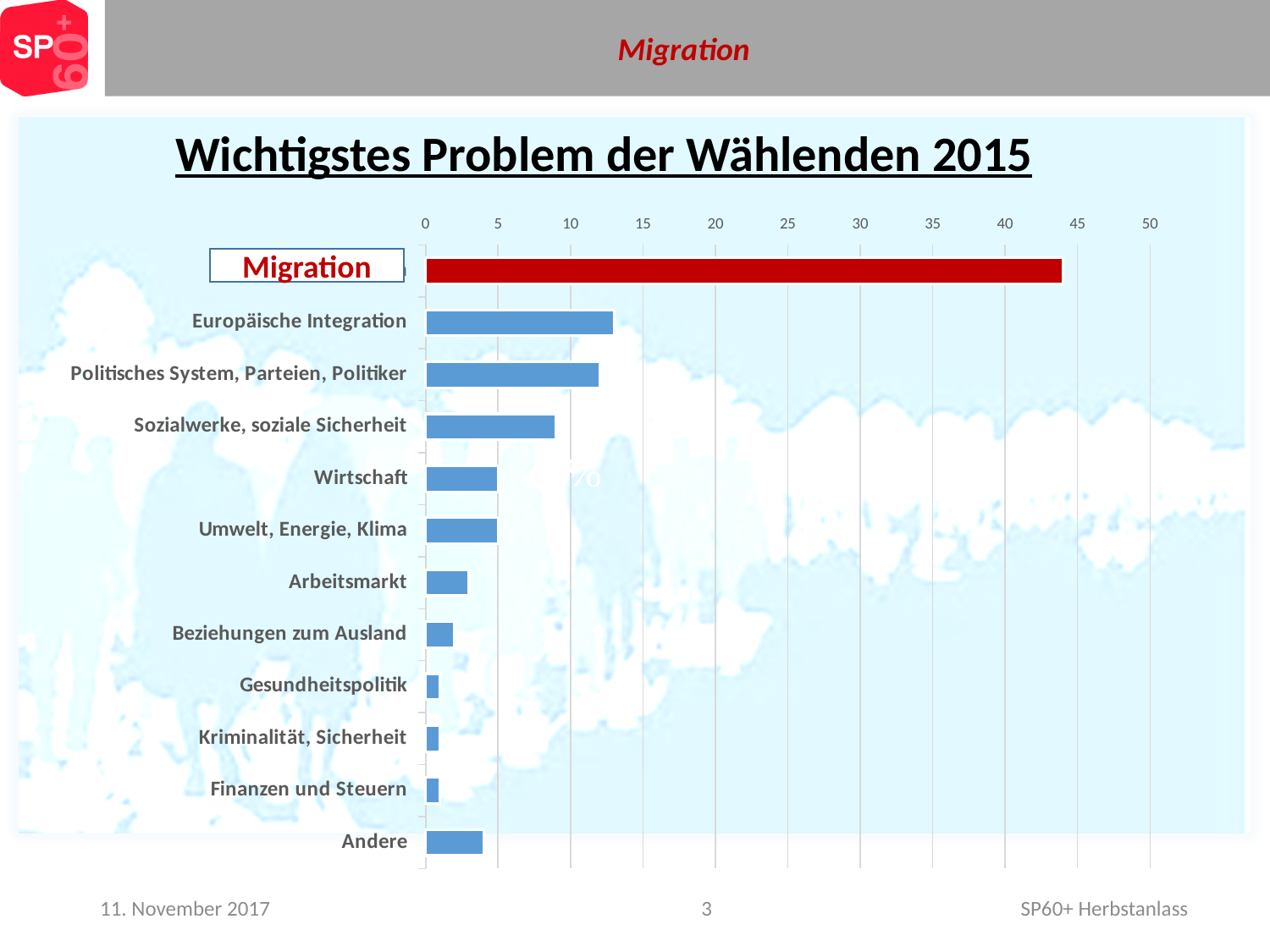
What type of chart is shown on the slide? bar chart Is the value for Sozialwerke, soziale Sicherheit greater or less than 10? less Which is larger, the value for Migration or the value for Europäische Integration? Migration Is the value for Migration greater or less than 40? greater Is the value for Europäische Integration greater or less than 10? greater What is the title of the chart? Wichtigstes Problem der Wählenden 2015 Which category has the highest value? Migration Which is larger, the value for Sozialwerke, soziale Sicherheit or the value for Arbeitsmarkt? Sozialwerke, soziale Sicherheit How many categories are plotted in the chart? 12 Which bar is coloured red instead of blue? Migration